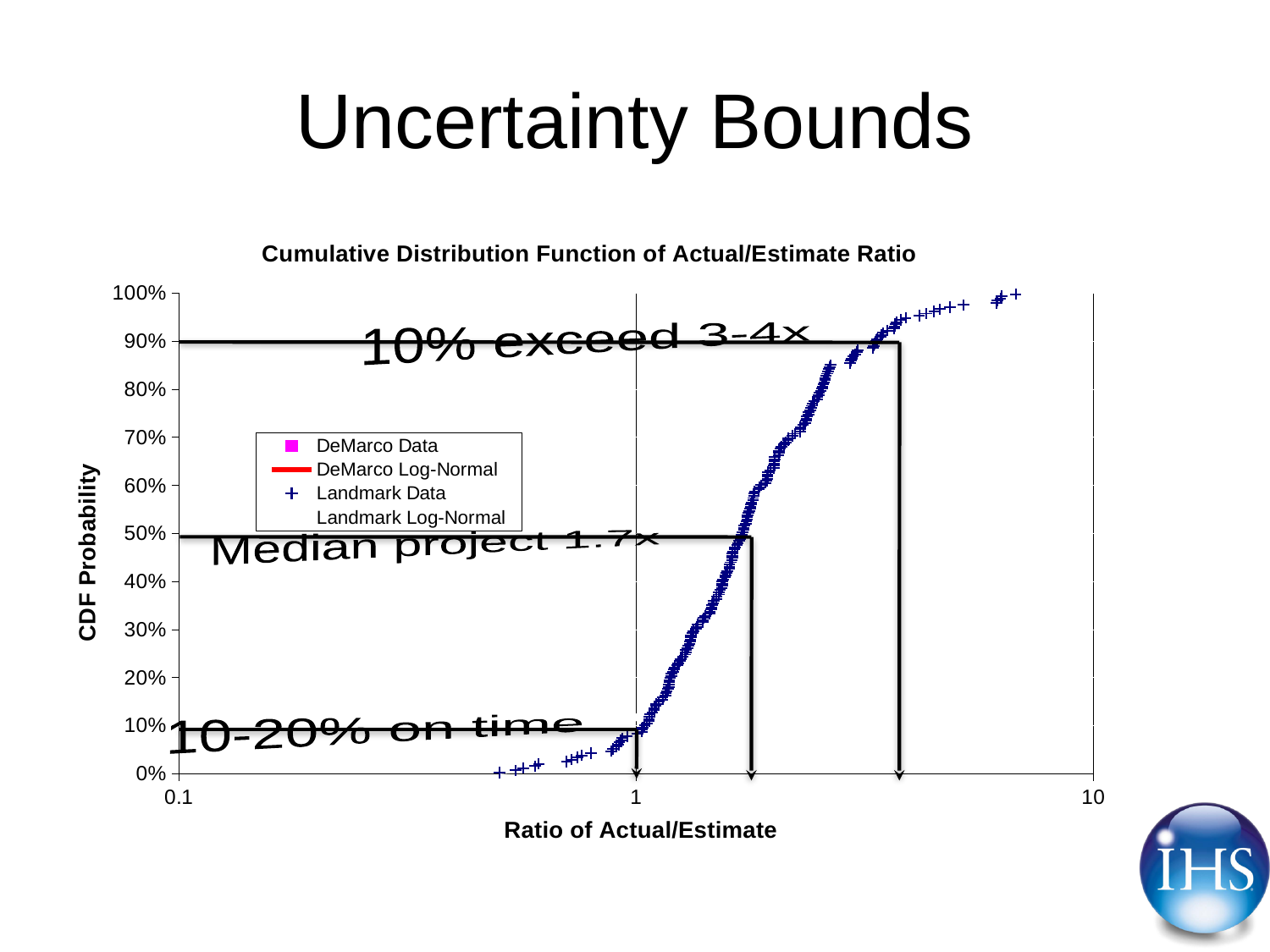
How many series does the chart legend list? 4 Is the CDF Probability of the Landmark Data at a ratio of 1 greater or less than 20%? less What is the label of the y axis? CDF Probability What is the lowest value shown on the x axis? 0.1 What kind of chart is shown on the slide? scatter chart Is the CDF Probability of the Landmark Data at a ratio of 1 greater or less than 0%? greater Do the plotted Landmark Data values rise or fall as the Ratio of Actual/Estimate increases? rise What is the highest value shown on the x axis? 10 What is the title of the chart? Cumulative Distribution Function of Actual/Estimate Ratio Which legend entry is marked with a blue plus symbol? Landmark Data According to the annotation on the chart, what ratio do 10% of projects exceed? 3-4x According to the annotation on the chart, what is the Actual/Estimate ratio of the median project? 1.7x